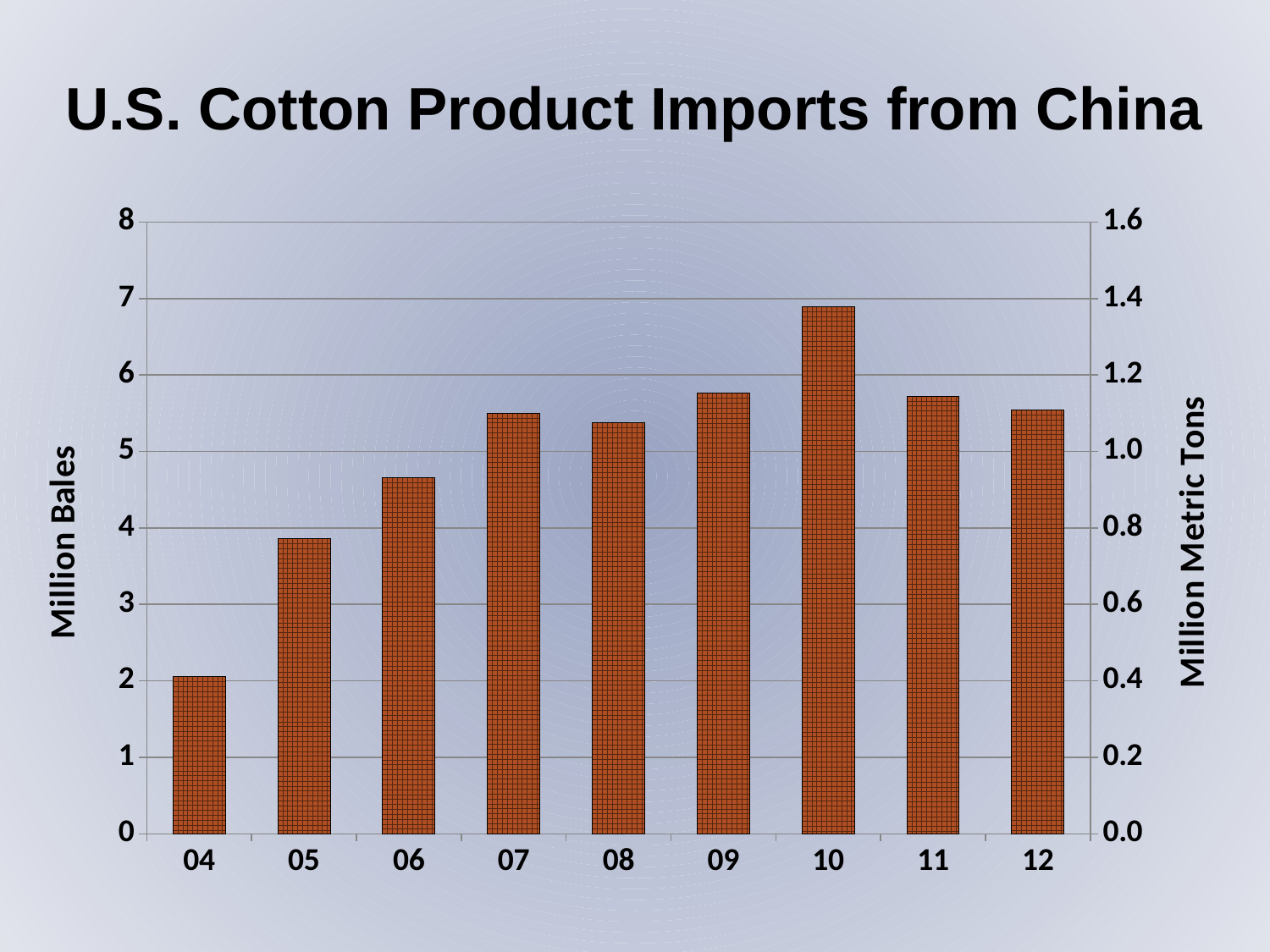
Do the values rise or fall from 04 to 07? rise How many years are shown on the x axis of the chart? 9 Is the value for 05 greater or less than 4 million bales? less Is the value for 06 greater or less than 4 million bales? greater Which year has the larger value, 09 or 10? 10 Which year has the highest value for U.S. cotton product imports from China? 10 What kind of chart is shown on the slide? bar chart What is the label on the left vertical axis of the chart? Million Bales Is the value for 04 greater or less than 3 million bales? less Which year has the lowest value for U.S. cotton product imports from China? 04 Which year has the larger value, 05 or 06? 06